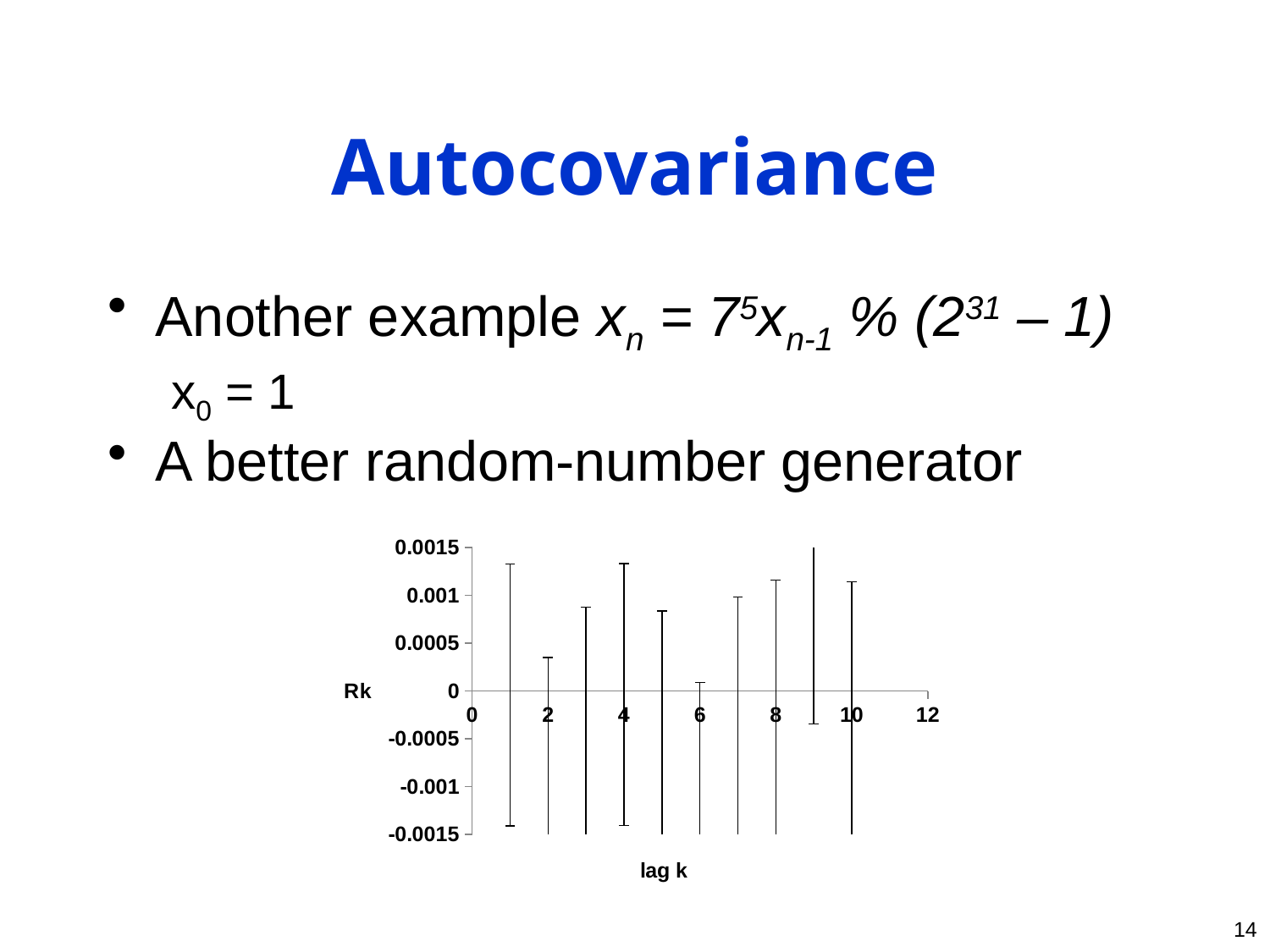
Is the top of the bar at lag 6 greater or less than 0.0005? less What is the label of the y axis of the chart? Rk Is the bottom of the bar at lag 9 greater or less than -0.001? greater Does the bar at lag 1 or the bar at lag 2 reach a higher value on the Rk axis? lag 1 What is the label of the x axis of the chart? lag k At which lag k does the plotted bar reach the highest value on the Rk axis? 9 How many lag values have a vertical bar plotted on the chart? 10 Is the top of the bar at lag 9 greater or less than 0.001? greater